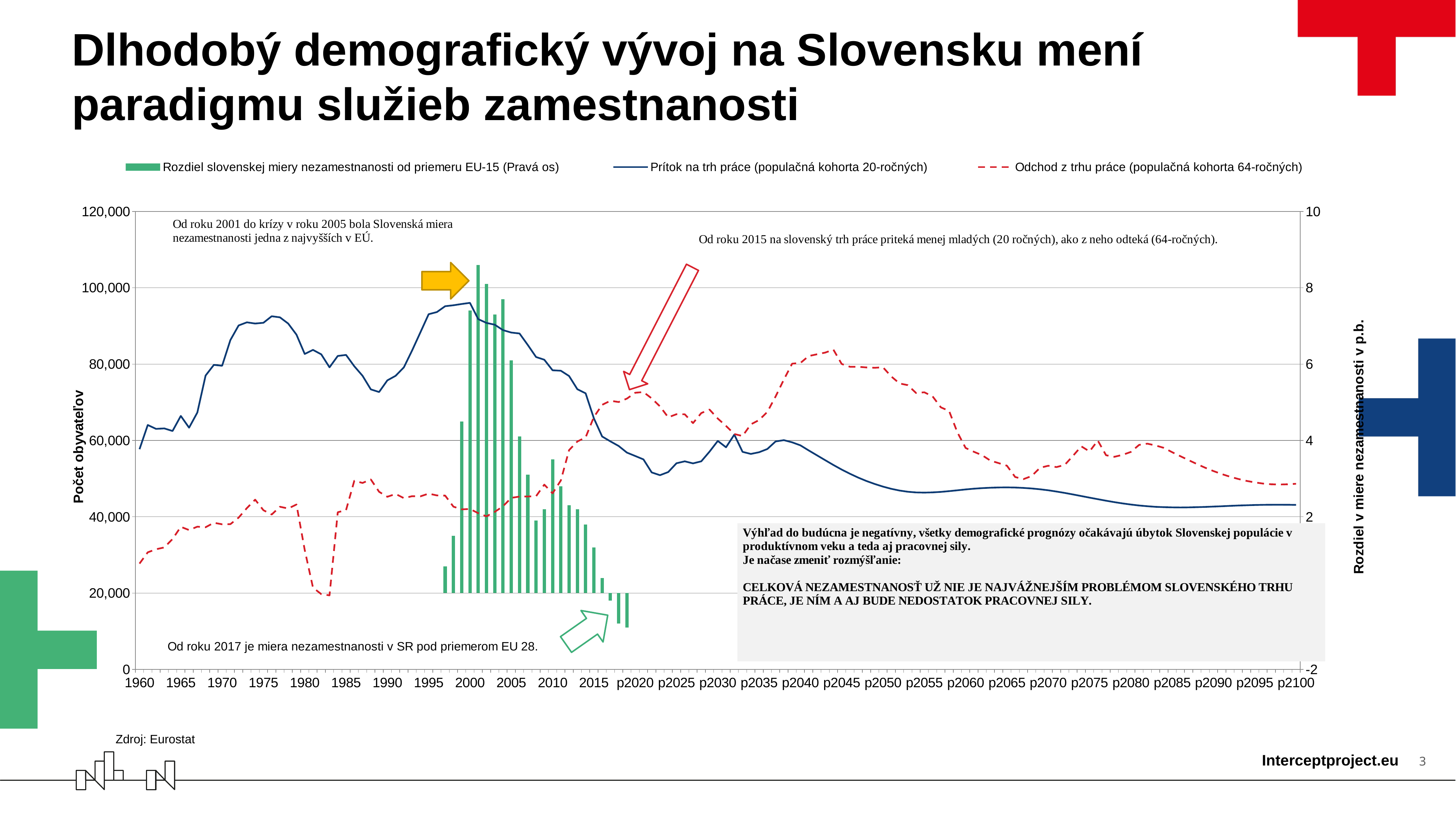
Is the highest green bar ('Rozdiel slovenskej miery nezamestnanosti od priemeru EU-15') greater or less than 8 on the right axis? greater Is the value of the 'Prítok na trh práce (populačná kohorta 20-ročných)' line at p2100 greater or less than 60,000? less What kind of chart is shown on the slide? Combined bar and line chart Is the value of the 'Odchod z trhu práce (populačná kohorta 64-ročných)' line in 1960 greater or less than 40,000? less At p2050, which is larger: the 'Prítok na trh práce' line or the 'Odchod z trhu práce' line? Odchod z trhu práce What source is cited below the chart? Zdroj: Eurostat In 2000, which is larger: the 'Prítok na trh práce' line or the 'Odchod z trhu práce' line? Prítok na trh práce Does the 'Odchod z trhu práce (populačná kohorta 64-ročných)' line rise or fall between 2015 and p2045? rise What is the title of the left vertical axis? Počet obyvateľov How many series does the chart legend list? 3 Does the 'Prítok na trh práce (populačná kohorta 20-ročných)' line rise or fall between p2040 and p2100? fall